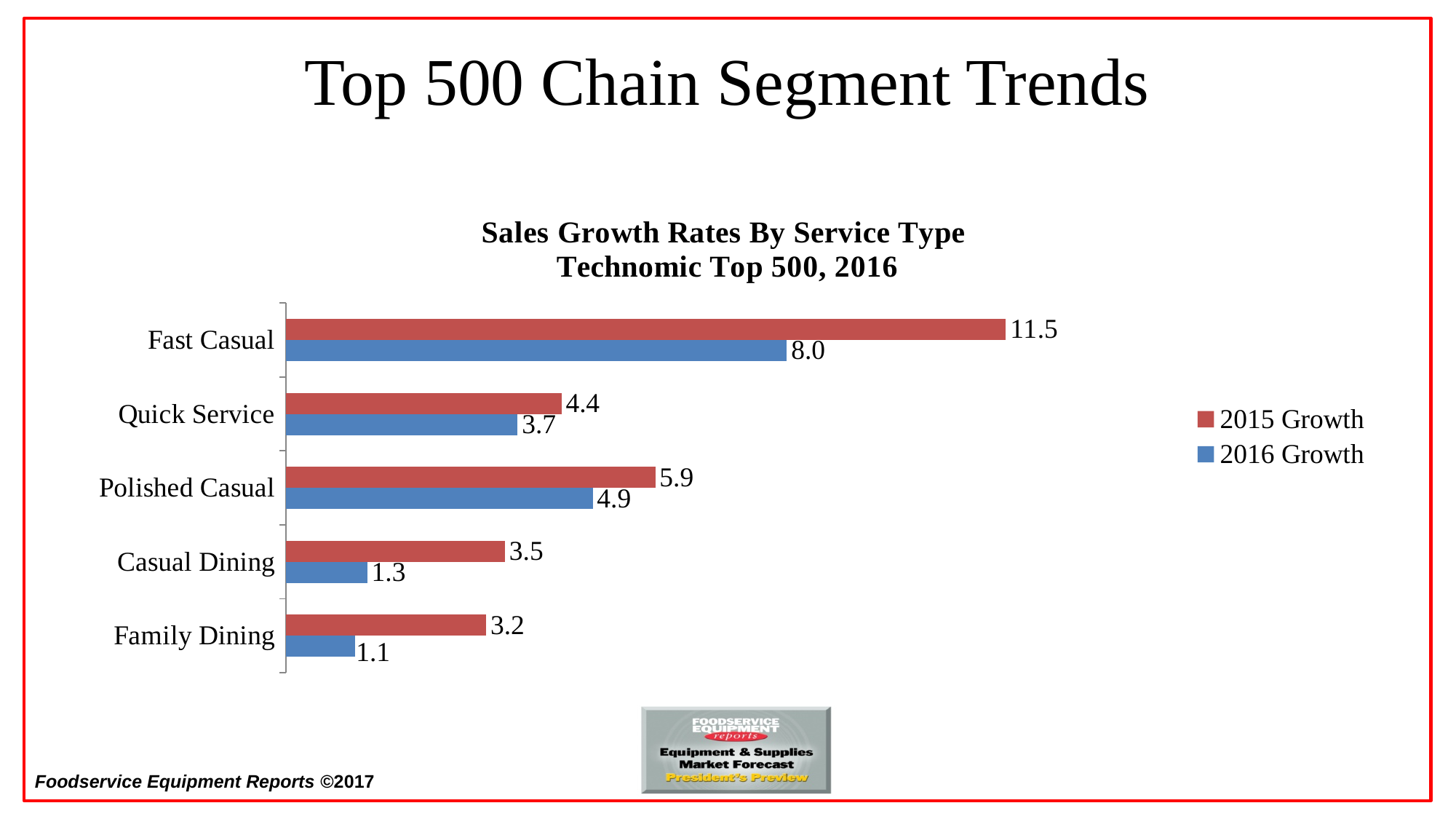
Which is larger: the 2016 Growth for Quick Service or the 2016 Growth for Polished Casual? Polished Casual Which service type has the highest 2016 Growth? Fast Casual Which service type has the lowest 2015 Growth? Family Dining What is the title of the chart? Sales Growth Rates By Service Type Technomic Top 500, 2016 What is the difference between the 2015 Growth and 2016 Growth values for Fast Casual? 3.5 What is the 2016 Growth value for Casual Dining? 1.3 What kind of chart is shown on the slide? Bar chart What is the 2015 Growth value for Fast Casual? 11.5 How many series does the legend list? 2 What is the 2016 Growth value for Polished Casual? 4.9 What is the difference between the 2015 Growth values for Polished Casual and Quick Service? 1.5 How many service types are shown in the chart? 5